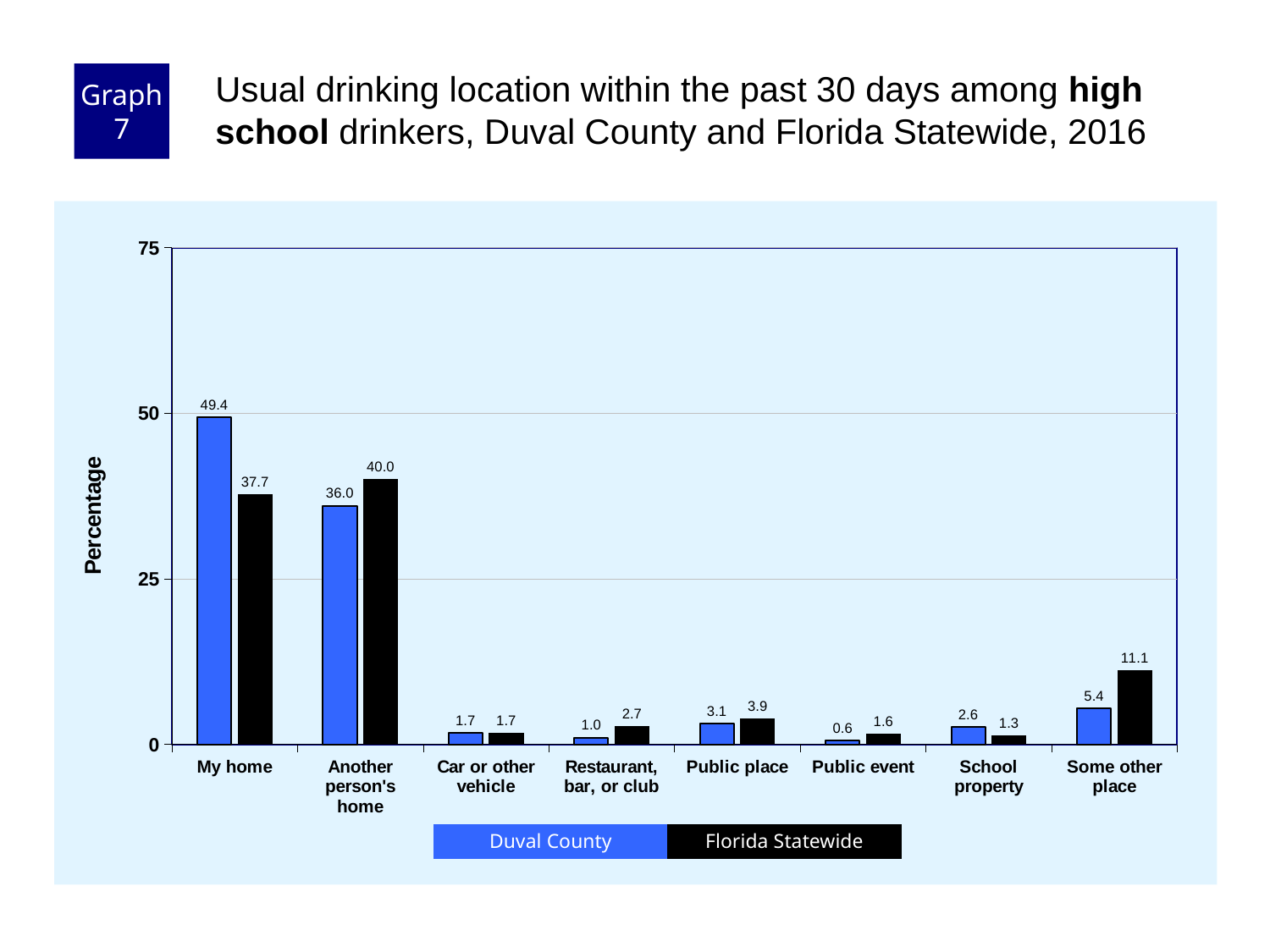
Which category has the highest Duval County value? My home Which is larger for Some other place, Duval County or Florida Statewide? Florida Statewide Is the Duval County value for Another person's home greater or less than 25? greater How many series does the legend list? 2 Which category has the lowest Florida Statewide value? School property What is the Duval County value for Public event? 0.6 What is the difference between the Duval County and Florida Statewide values for My home? 11.7 What is the Florida Statewide value for Another person's home? 40.0 What kind of chart is shown on the slide? Bar chart What is the Duval County value for My home? 49.4 How many categories are shown on the x axis? 8 What is the Florida Statewide value for Some other place? 11.1